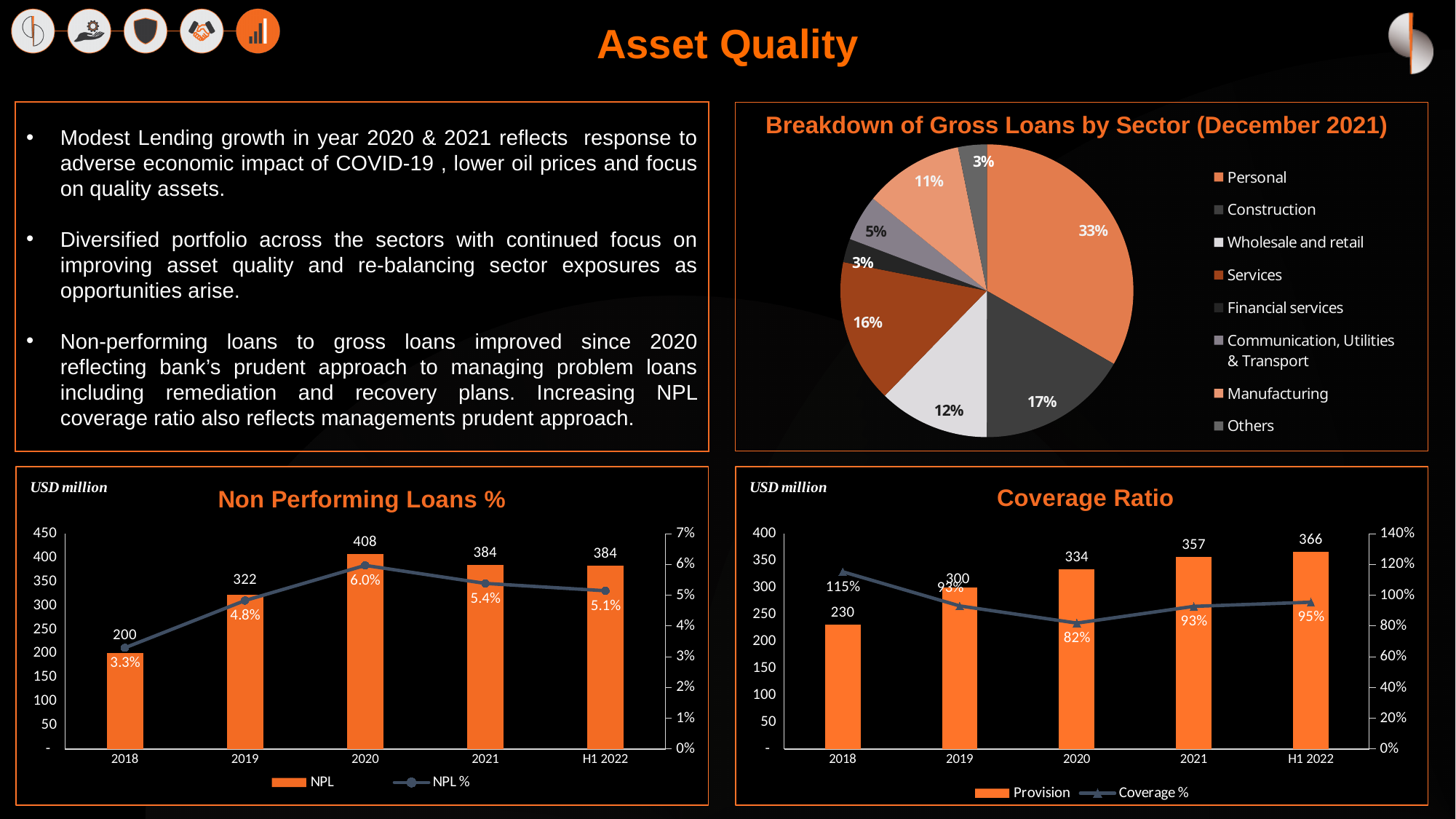
How many sectors are listed in the legend of the pie chart 'Breakdown of Gross Loans by Sector (December 2021)'? 8 In the 'Non Performing Loans %' chart, what is the difference between the NPL values for 2020 and 2019? 86 What kind of chart is the 'Coverage Ratio' chart? A bar chart combined with a line chart In the 'Coverage Ratio' chart, do the Provision values rise or fall from 2018 to H1 2022? Rise In the 'Non Performing Loans %' chart, which year has the highest NPL value? 2020 In the pie chart 'Breakdown of Gross Loans by Sector (December 2021)', which sector has the largest share? Personal In the pie chart 'Breakdown of Gross Loans by Sector (December 2021)', what share does Services have? 16% In the 'Coverage Ratio' chart, what is the Provision value for H1 2022? 366 In the 'Non Performing Loans %' chart, what is the NPL value for 2020? 408 In the 'Non Performing Loans %' chart, what is the NPL % for 2018? 3.3% In the 'Coverage Ratio' chart, what is the Coverage % for 2020? 82% In the pie chart 'Breakdown of Gross Loans by Sector (December 2021)', what share of gross loans is Personal? 33%